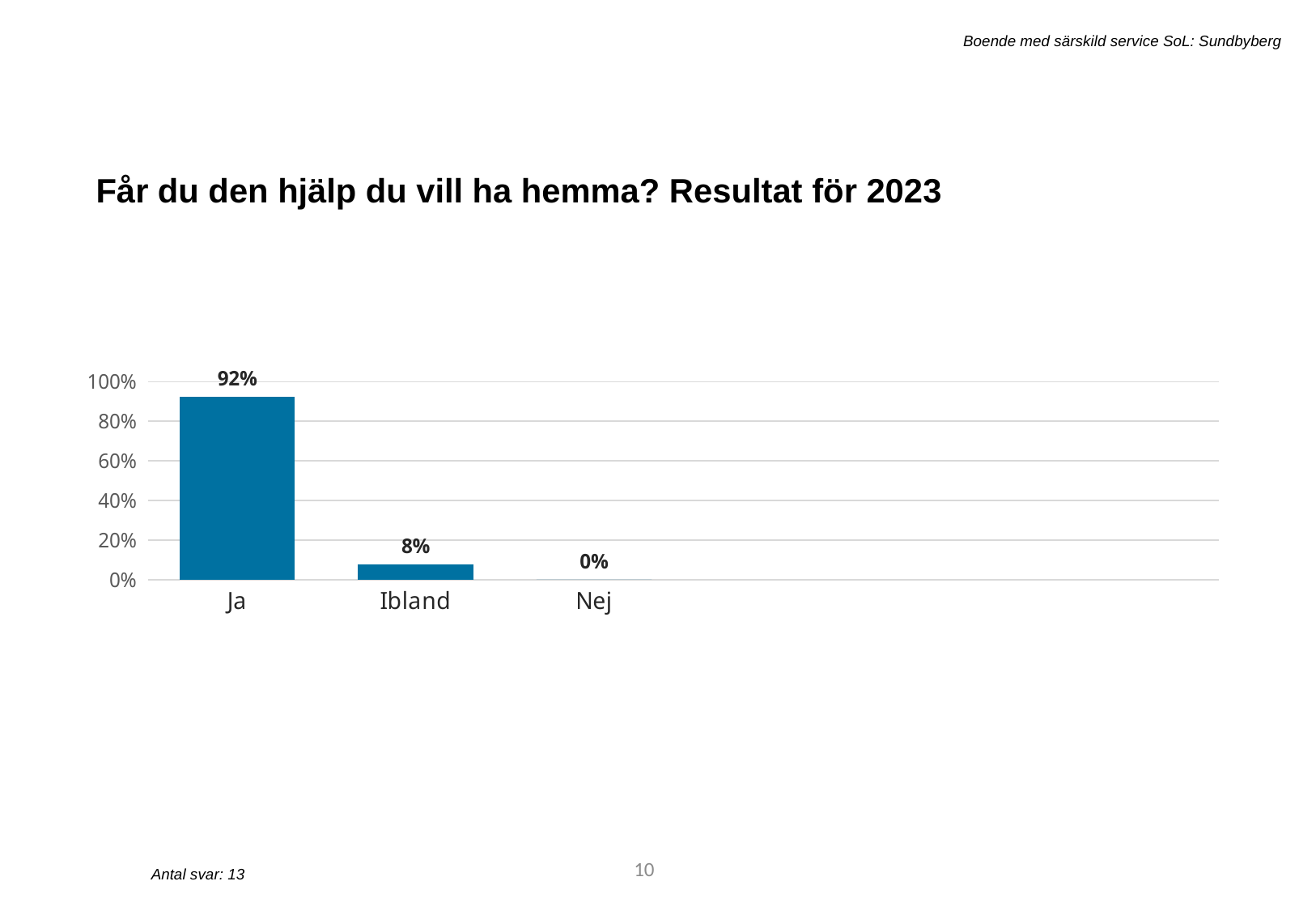
What is the value for Nej? 0% Is the value for Ja greater or less than 80%? greater What is the value for Ibland? 8% Which category has the lowest value? Nej Which category has the highest value? Ja What kind of chart is shown on the slide? bar chart How many categories are shown on the x axis? 3 What is the difference between the values for Ja and Ibland? 84% What is the title of the chart on the slide? Får du den hjälp du vill ha hemma? Resultat för 2023 Is the value for Ibland greater or less than 20%? less What is the value for Ja? 92% Which is larger, the value for Ibland or the value for Nej? Ibland